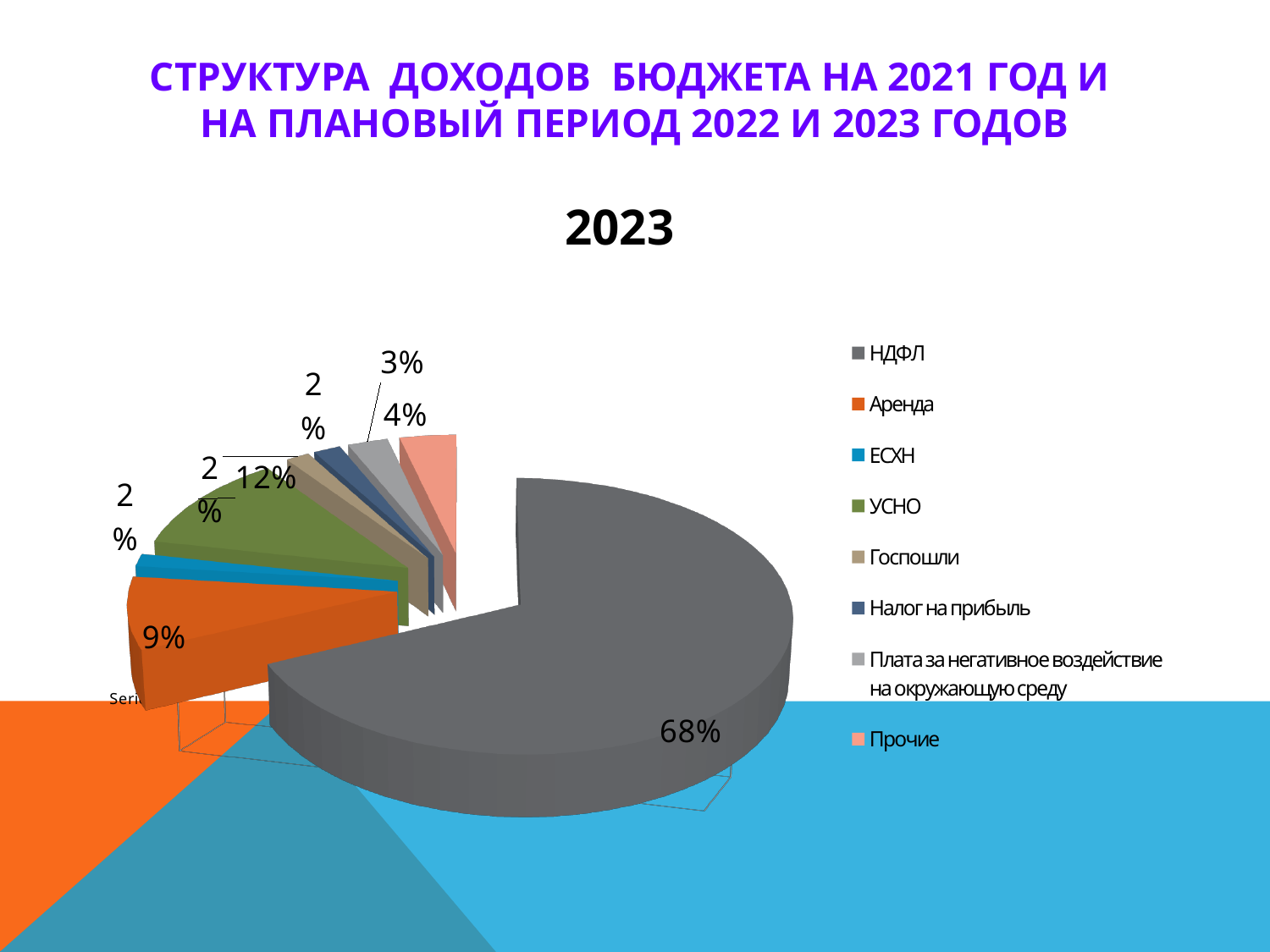
What colour represents Аренда in the chart? Orange What percentage is shown for Аренда? 9% What share of the pie does НДФЛ account for? 68% What percentage is shown for Прочие? 4% What type of chart is shown on the slide? Pie chart What percentage is shown for Плата за негативное воздействие на окружающую среду? 3% What is the difference in percentage points between НДФЛ and УСНО? 56 What percentage is shown for УСНО? 12% What is the title of the chart? 2023 Which is larger, the share for Аренда or the share for УСНО? УСНО How many categories does the legend list? 8 Which category has the largest slice of the pie? НДФЛ